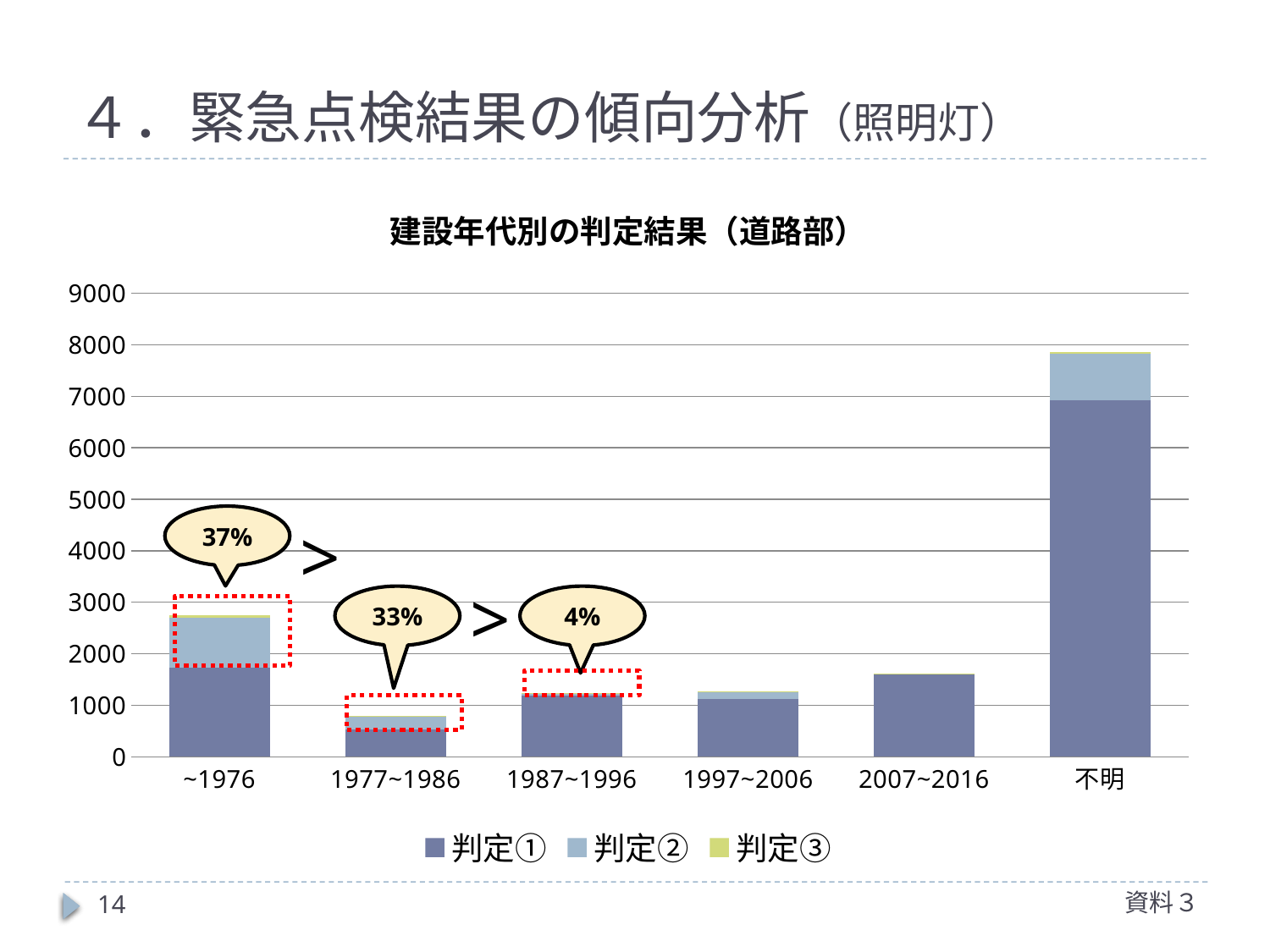
Is the total value for 1977~1986 greater or less than 1000? less Which has the larger total bar, ~1976 or 2007~2016? ~1976 Which category has the shortest stacked bar? 1977~1986 What is the title of the chart? 建設年代別の判定結果（道路部） Which category has the tallest stacked bar? 不明 How many construction-period categories are shown on the x axis? 6 What percentage is shown in the callout above the ~1976 bar? 37% Is the total value for 不明 greater or less than 7000? greater How many series does the legend list? 3 Is the total value for ~1976 greater or less than 3000? less What kind of chart is shown on the slide? Stacked bar chart